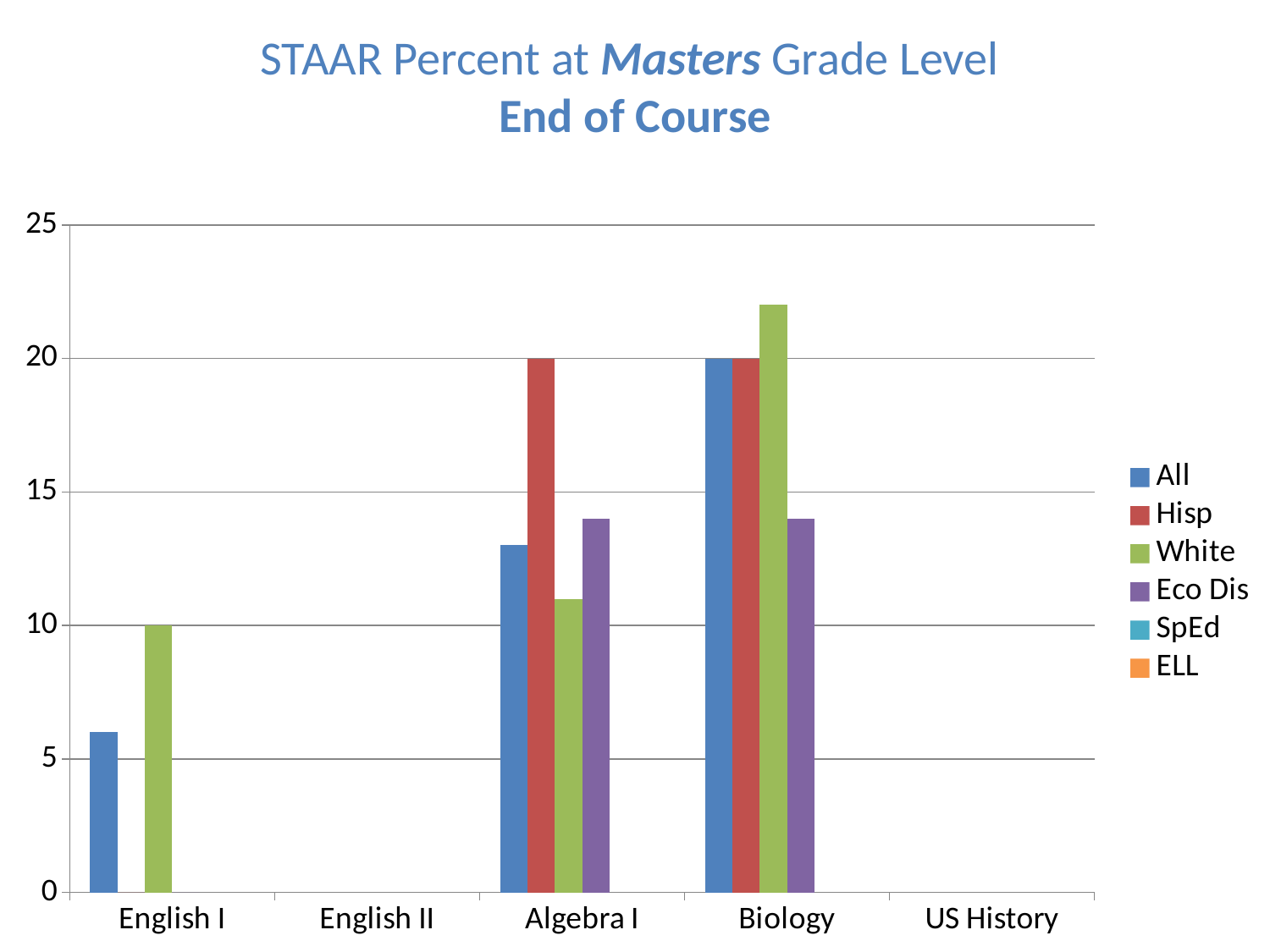
What is the value for White in English I? 10 How many series does the legend list? 6 Is the value for All in English I greater or less than 5? greater What is the value for All in Biology? 20 What kind of chart is shown on the slide? bar chart Which is larger in Algebra I, the value for All or the value for Hisp? Hisp How many course categories are shown on the x axis? 5 What is the value for Hisp in Algebra I? 20 Is the value for Eco Dis in Algebra I greater or less than 15? less Is the value for White in Biology greater or less than 20? greater Which series has the lowest value in Algebra I? White Which series has the highest value in Biology? White